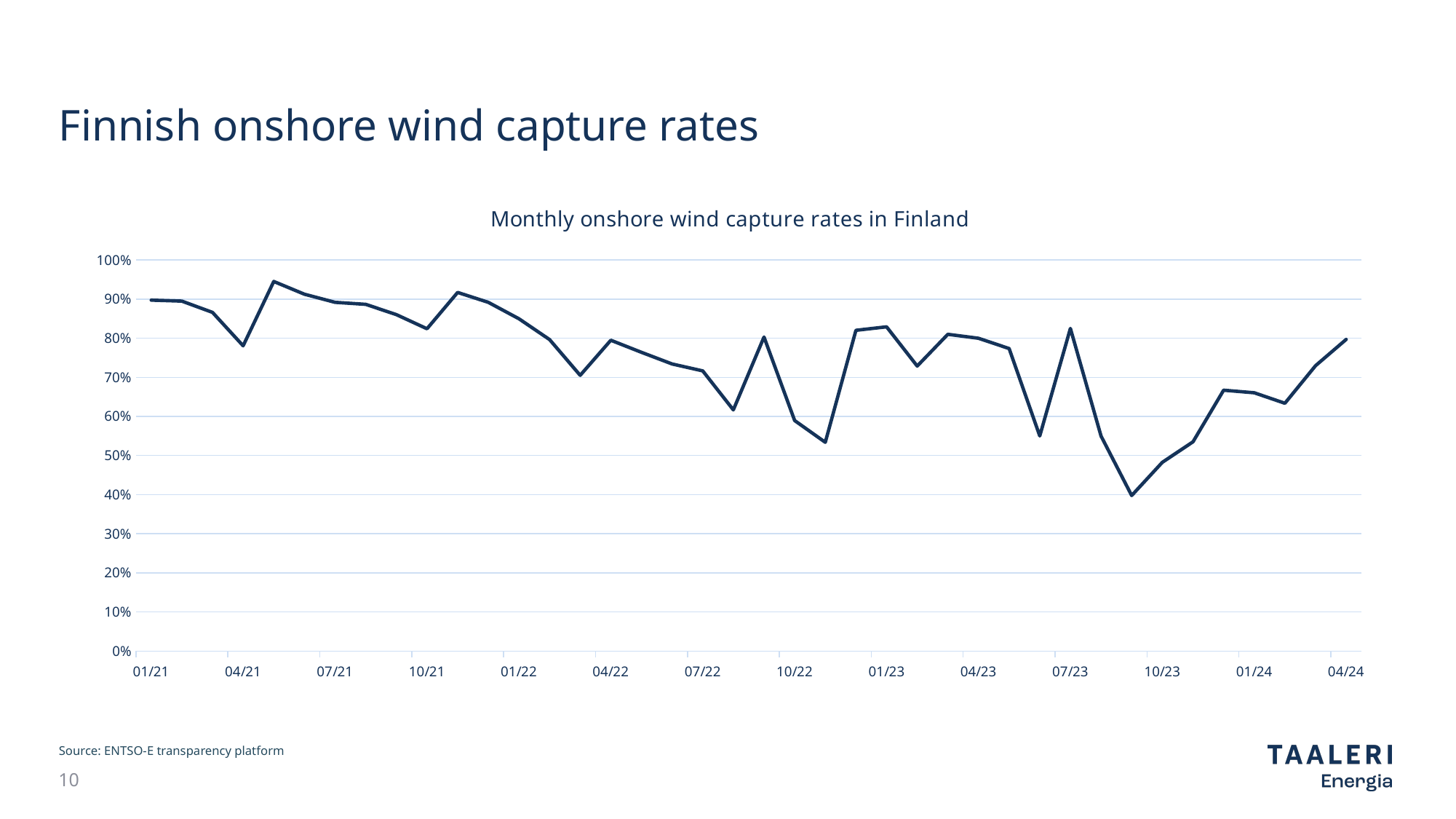
Is the value for 10/22 greater or less than 70%? less What is the title of the chart? Monthly onshore wind capture rates in Finland Between 10/23 and 04/24, does the line rise or fall? rise Which has the higher capture rate, 01/23 or 10/23? 01/23 Is the value for 01/21 greater or less than 80%? greater What source is cited for the chart data? ENTSO-E transparency platform Is the value for 07/23 greater or less than 70%? greater Which has the higher capture rate, 01/21 or 04/24? 01/21 What kind of chart is shown on the slide? line chart